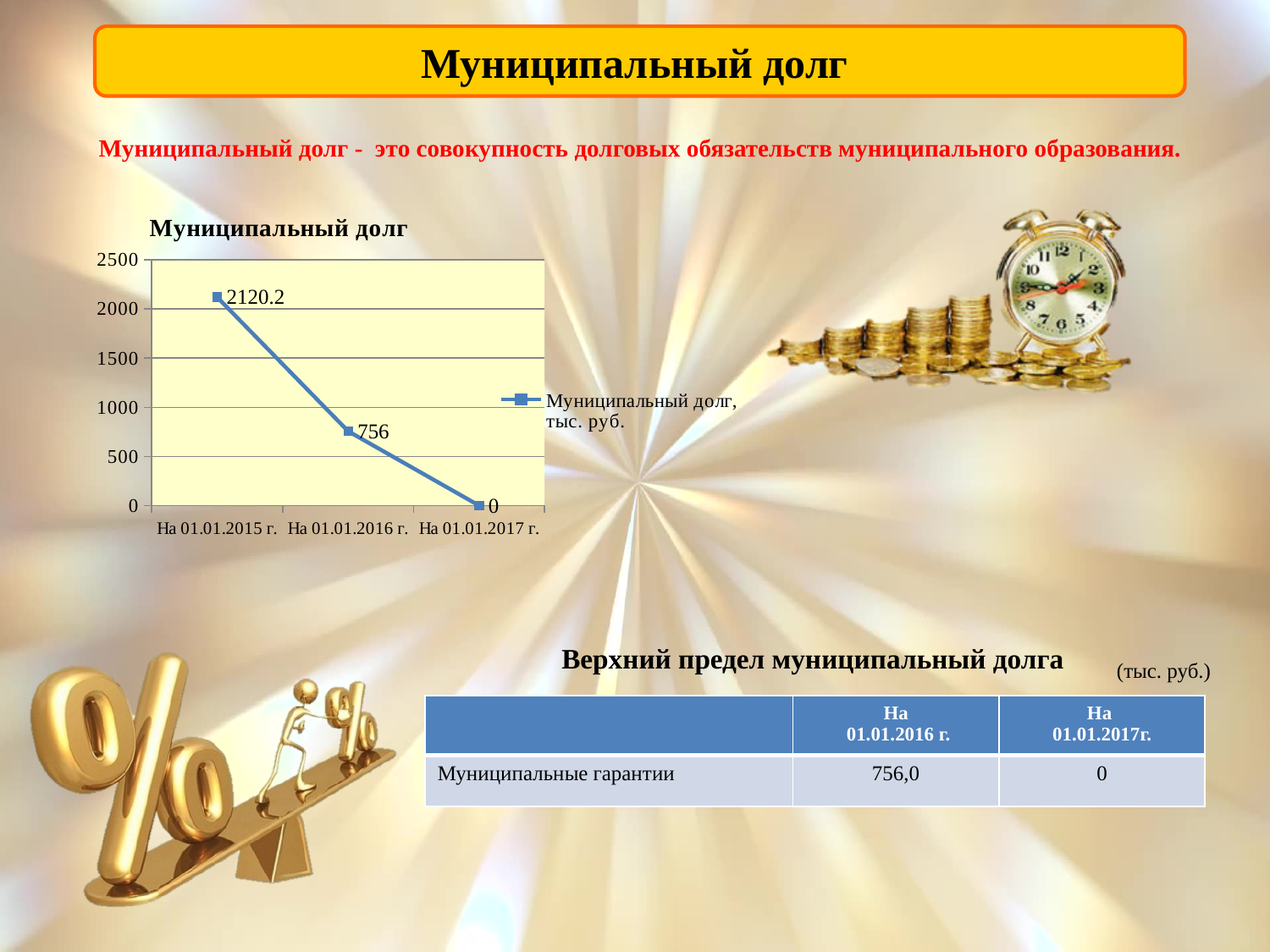
Which date has the lowest value in the chart? На 01.01.2017 г. How many series does the chart legend list? 1 How many data points are plotted in the chart? 3 Do the values rise or fall from На 01.01.2015 г. to На 01.01.2017 г.? fall Which is larger, the value for На 01.01.2016 г. or the value for На 01.01.2017 г.? На 01.01.2016 г. What is the value for На 01.01.2017 г. in the chart? 0 What is the difference between the values for На 01.01.2015 г. and На 01.01.2016 г.? 1364.2 What kind of chart is shown on the slide? line chart Which date has the highest value in the chart? На 01.01.2015 г. What is the value for На 01.01.2016 г. in the chart? 756 What is the value for На 01.01.2015 г. in the chart? 2120.2 Is the value for На 01.01.2015 г. greater or less than 2000? greater